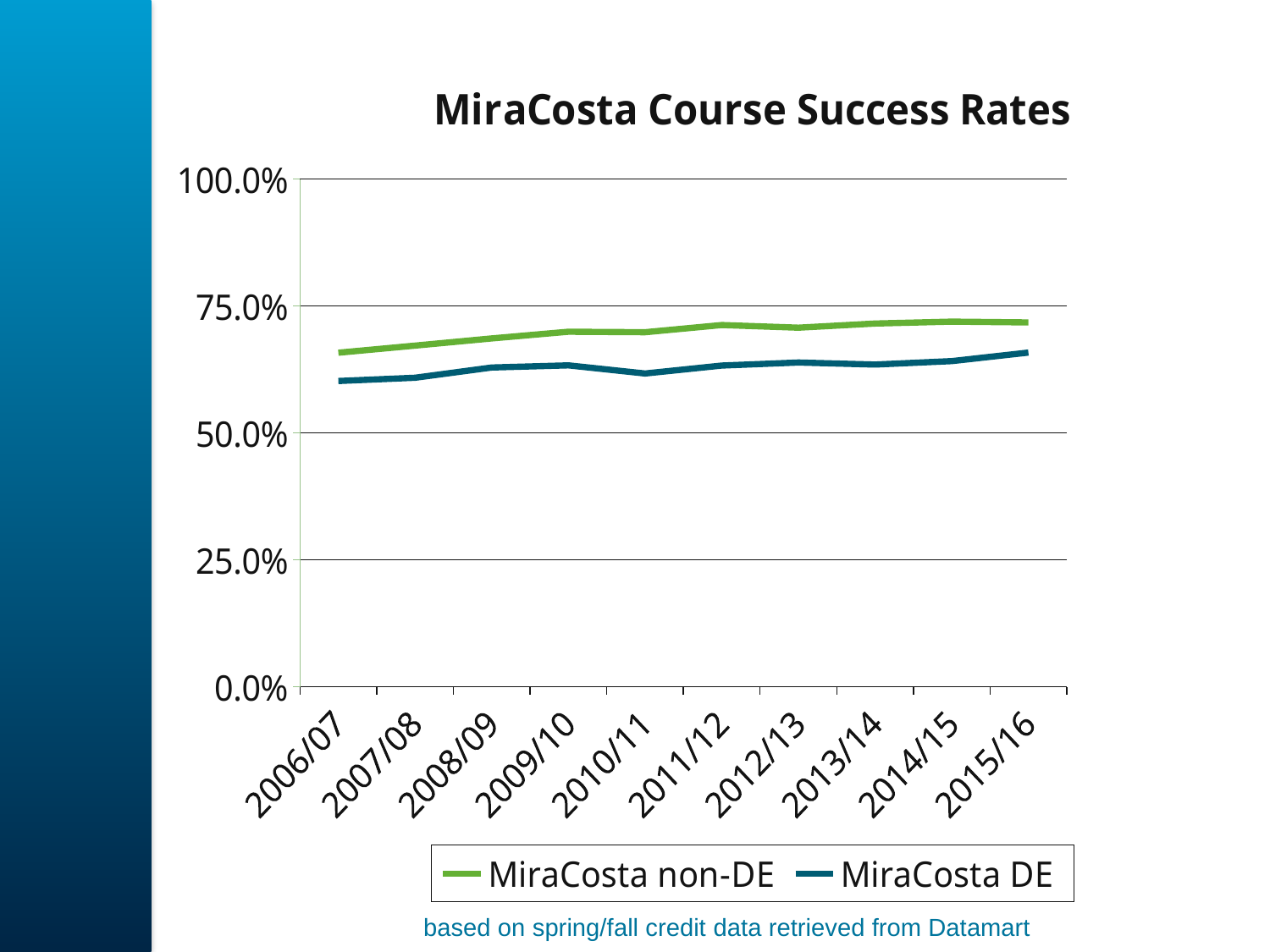
Is the MiraCosta DE value for 2010/11 greater or less than 75.0%? less What kind of chart is shown on the slide? line chart Which series is drawn in green? MiraCosta non-DE What is the title of the chart? MiraCosta Course Success Rates In which year is the MiraCosta non-DE success rate lowest? 2006/07 Is the MiraCosta non-DE value for 2015/16 greater or less than 75.0%? less Does the MiraCosta DE success rate generally rise or fall from 2006/07 to 2015/16? rise How many academic years are plotted along the x axis? 10 In which year is the MiraCosta DE success rate lowest? 2006/07 How many series does the legend list? 2 Is the MiraCosta DE value for 2006/07 greater or less than 50.0%? greater In 2012/13, which series has the higher success rate, MiraCosta non-DE or MiraCosta DE? MiraCosta non-DE